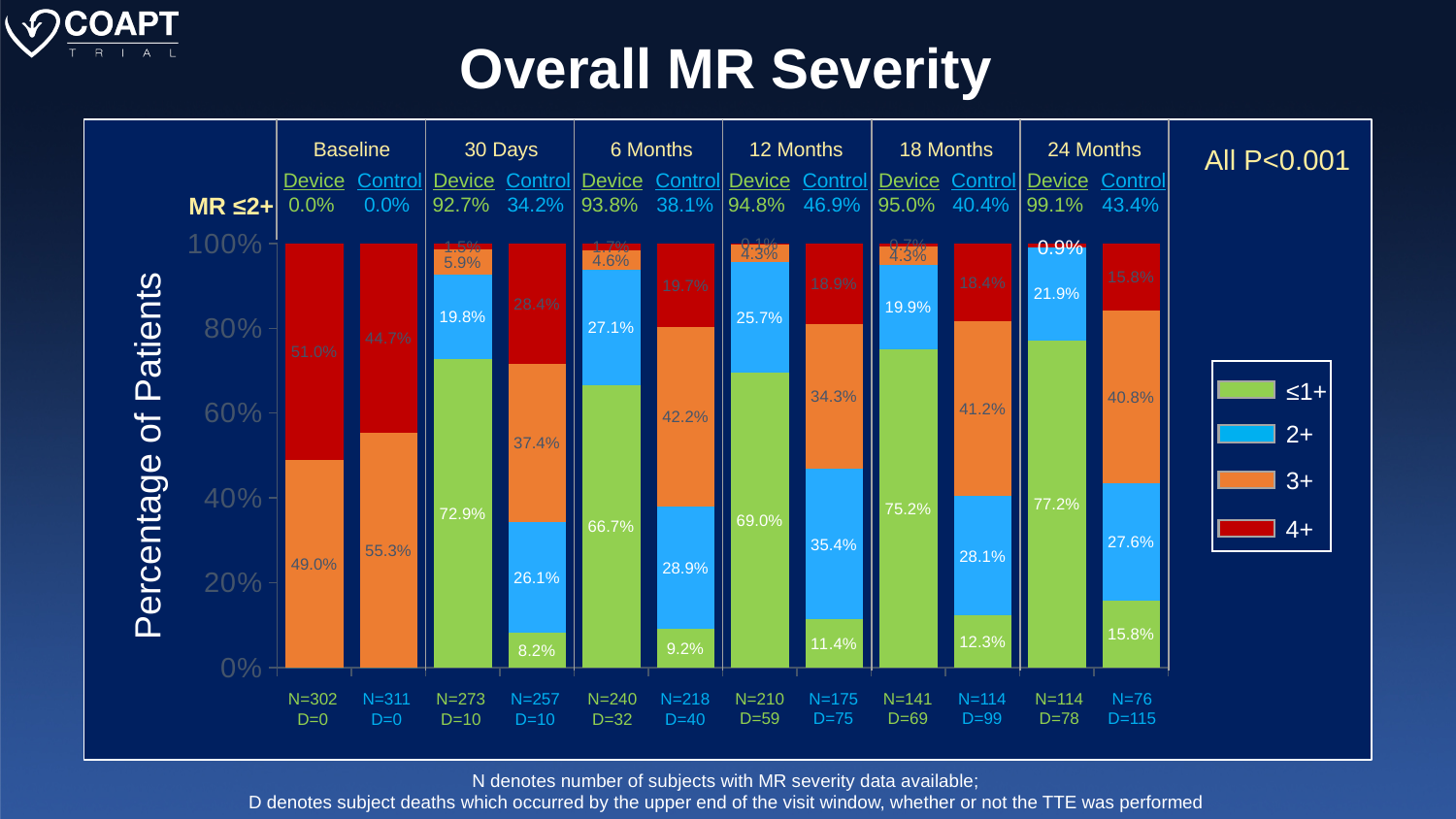
What is the MR ≤2+ percentage for the Device group at 12 Months? 94.8% What is the difference between the MR ≤1+ percentages of the Device and Control groups at 30 Days? 64.7% What type of chart is shown on the slide? stacked bar chart Among the Control bars from 30 Days onward, at which time point is the MR ≤1+ segment the smallest? 30 Days Among the Device bars, at which time point is the MR ≤1+ segment the largest? 24 Months At 18 Months, which group has the larger MR 2+ segment, Device or Control? Control What percentage of Control patients had MR 3+ at 6 Months? 42.2% What percentage of Control patients had MR 4+ at Baseline? 44.7% What is the N value shown for the Control group at 24 Months? N=76 How many series does the legend list? 4 How many bars are plotted in the chart? 12 What percentage of Device patients had MR ≤1+ at 24 Months? 77.2%